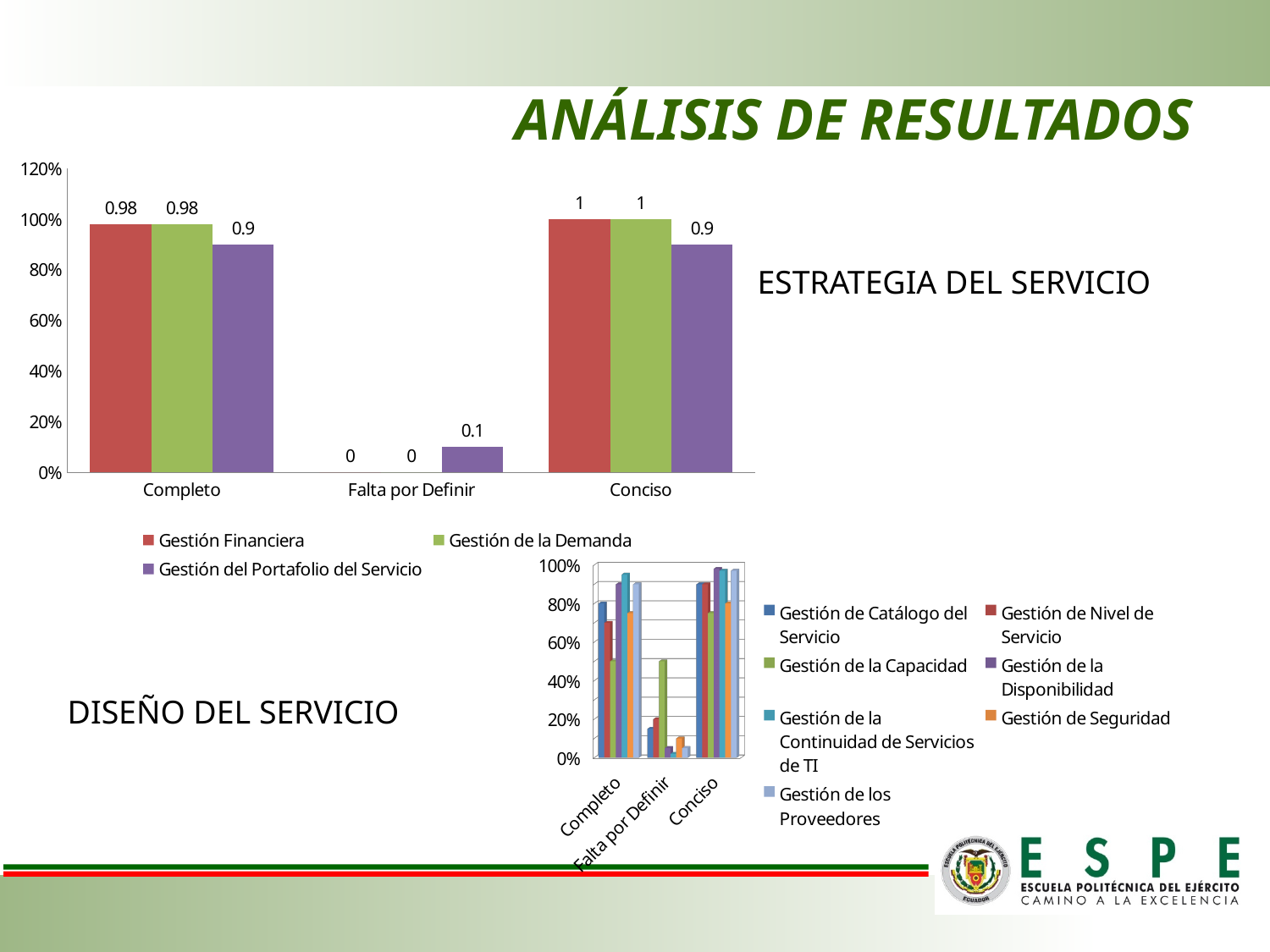
What kind of chart is the Diseño del Servicio chart? Bar chart In the Estrategia del Servicio chart, what is the value of Gestión del Portafolio del Servicio for Conciso? 0.9 How many series does the legend of the Estrategia del Servicio chart list? 3 In the Estrategia del Servicio chart, which series has the lowest value for Completo? Gestión del Portafolio del Servicio In the Estrategia del Servicio chart, which is larger for Conciso: Gestión Financiera or Gestión del Portafolio del Servicio? Gestión Financiera In the Estrategia del Servicio chart, what is the difference between Gestión Financiera and Gestión del Portafolio del Servicio for Completo? 0.08 How many categories are shown on the x axis of the Diseño del Servicio chart? 3 In the Estrategia del Servicio chart, what is the value of Gestión de la Demanda for Conciso? 1 In the Estrategia del Servicio chart, what is the value of Gestión Financiera for Completo? 0.98 In the Estrategia del Servicio chart, what is the value of Gestión del Portafolio del Servicio for Falta por Definir? 0.1 In the Diseño del Servicio chart, is the value of Gestión de Catálogo del Servicio for Completo greater or less than 60%? greater How many series does the legend of the Diseño del Servicio chart list? 7